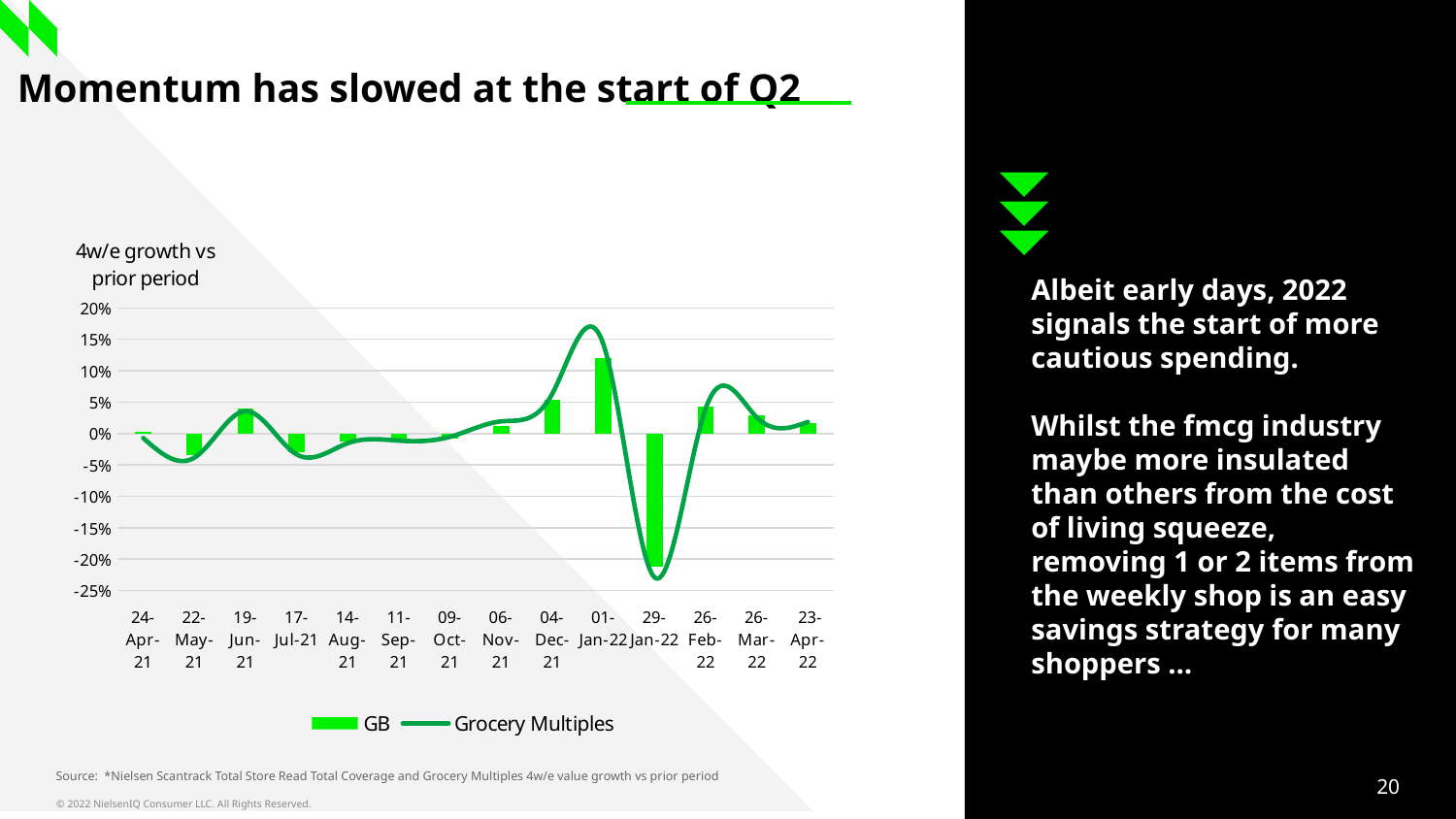
Is the GB value for 01-Jan-22 greater or less than 10%? greater Is the GB value for 29-Jan-22 greater or less than -20%? less At which date is the GB bar highest? 01-Jan-22 Which is larger, the GB value for 22-May-21 or for 19-Jun-21? 19-Jun-21 How many series does the legend list? 2 Do the GB and Grocery Multiples values rise or fall between 01-Jan-22 and 29-Jan-22? fall How many dates are shown along the x axis? 14 What label is shown above the vertical axis of the chart? 4w/e growth vs prior period What kind of chart is shown on the slide? A combined bar and line chart At which date is the GB bar lowest? 29-Jan-22 What are the two series named in the legend? GB and Grocery Multiples